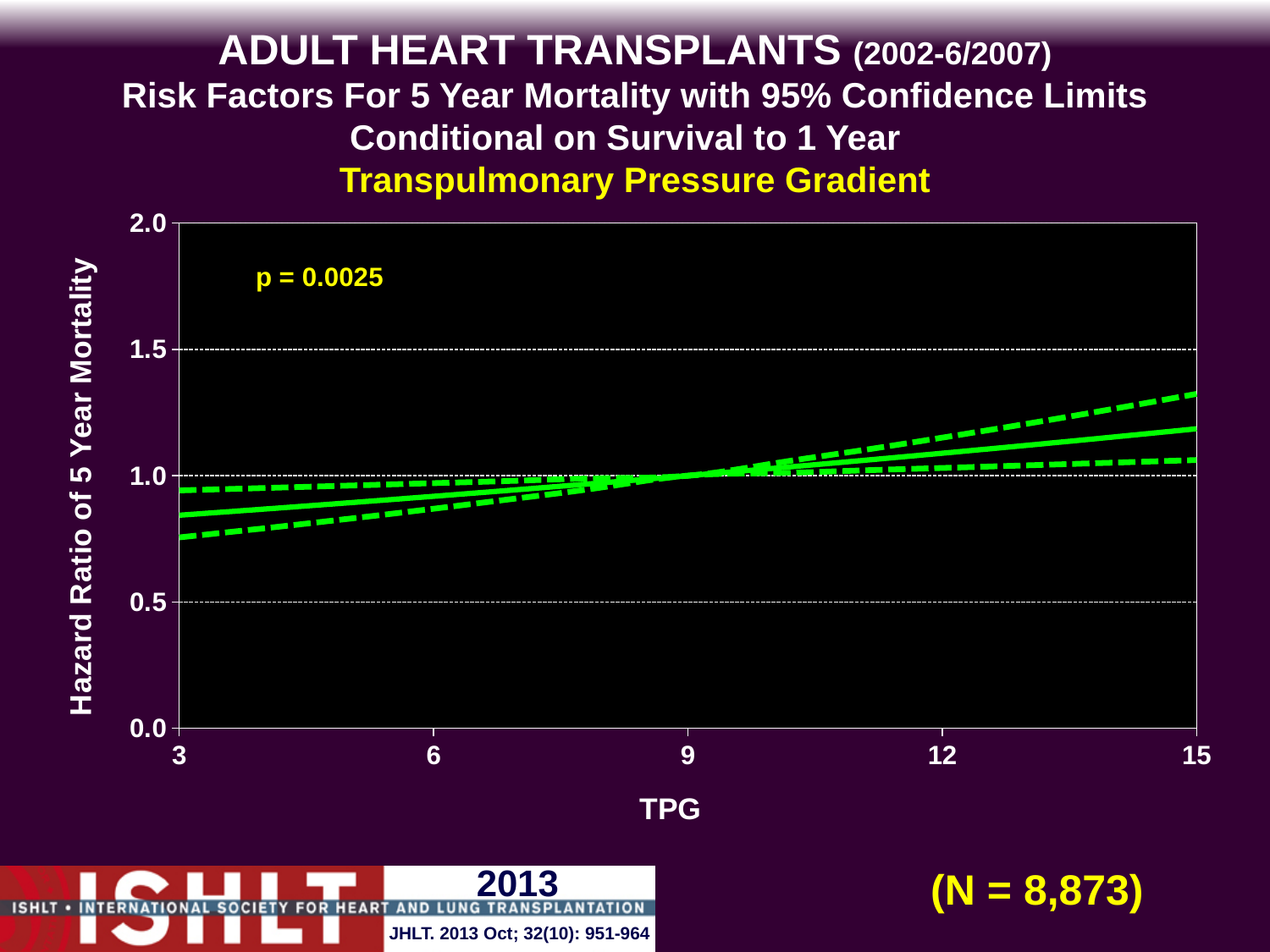
What kind of chart is shown on the slide? line chart Is the hazard ratio (solid line) at a TPG of 3 greater or less than 1.0? less Is the upper confidence limit at a TPG of 15 greater or less than 1.5? less Is the hazard ratio (solid line) at a TPG of 15 greater or less than 1.0? greater What p-value is printed on the chart? p = 0.0025 Is the hazard ratio (solid line) higher at a TPG of 15 or at a TPG of 3? 15 What is the label of the x axis? TPG What is the label of the y axis? Hazard Ratio of 5 Year Mortality What is the highest value shown on the y axis? 2.0 Does the hazard ratio rise or fall as TPG increases from 3 to 15? rise What is the sample size (N) shown on the slide? N = 8,873